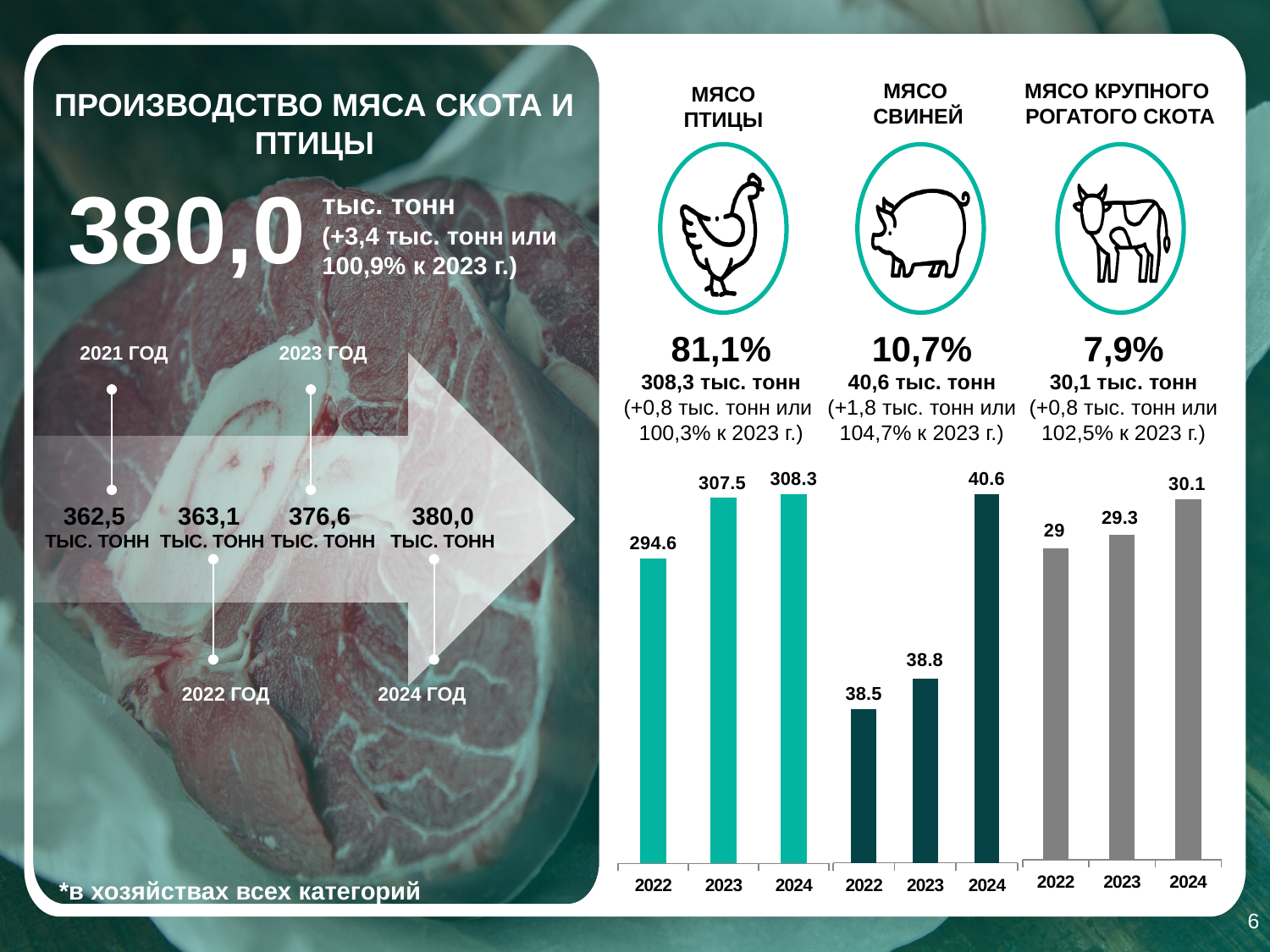
In the bar chart under "МЯСО СВИНЕЙ", what is the value for 2022? 38.5 In the bar chart under "МЯСО КРУПНОГО РОГАТОГО СКОТА", what is the difference between the 2024 and 2022 values? 1.1 In the bar chart under "МЯСО ПТИЦЫ", what is the difference between the 2023 and 2022 values? 12.9 In the bar chart under "МЯСО СВИНЕЙ", do the values rise or fall from 2022 to 2024? Rise In the bar chart under "МЯСО СВИНЕЙ", which is larger, the value for 2023 or the value for 2024? 2024 What kind of chart is shown under "МЯСО ПТИЦЫ"? Bar chart In the bar chart under "МЯСО ПТИЦЫ", what is the value for 2024? 308.3 What colour are the bars in the bar chart under "МЯСО КРУПНОГО РОГАТОГО СКОТА"? Grey In the bar chart under "МЯСО СВИНЕЙ", which year has the highest value? 2024 In the bar chart under "МЯСО КРУПНОГО РОГАТОГО СКОТА", what is the value for 2023? 29.3 In the bar chart under "МЯСО ПТИЦЫ", which year has the lowest value? 2022 How many bars are in the bar chart under "МЯСО КРУПНОГО РОГАТОГО СКОТА"? 3